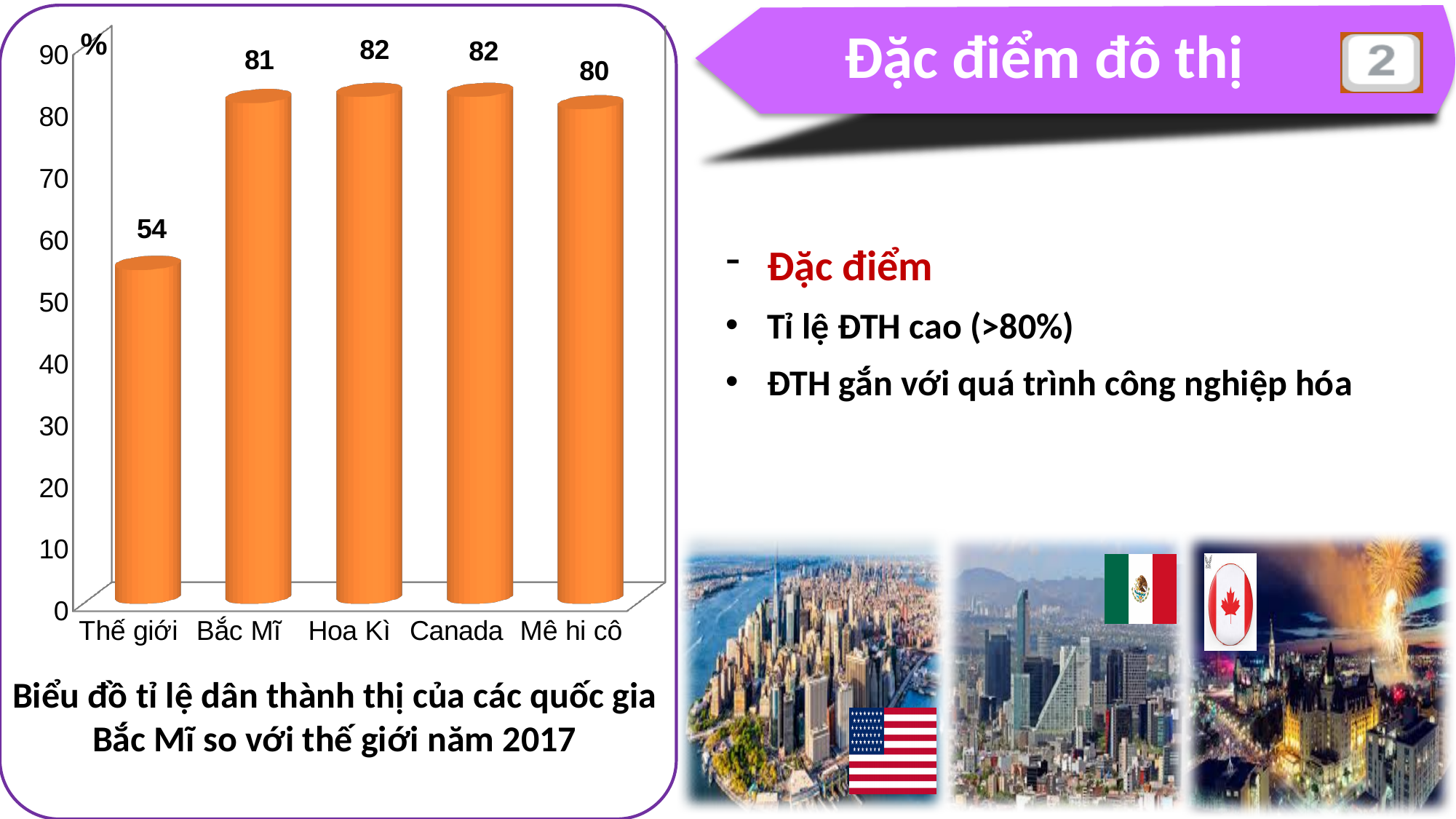
What is the value for Canada in the chart? 82 How many categories are shown in the chart? 5 What is the value for Thế giới in the chart? 54 What is the value for Mê hi cô in the chart? 80 What is the difference between the values for Hoa Kì and Thế giới? 28 Which category has the lowest value in the chart? Thế giới What unit is shown at the top of the vertical axis of the chart? % Is the value for Thế giới greater or less than 60? less What is the value for Bắc Mĩ in the chart? 81 Which is larger, the value for Bắc Mĩ or the value for Thế giới? Bắc Mĩ What is the difference between the values for Bắc Mĩ and Mê hi cô? 1 What kind of chart is shown on the slide? bar chart